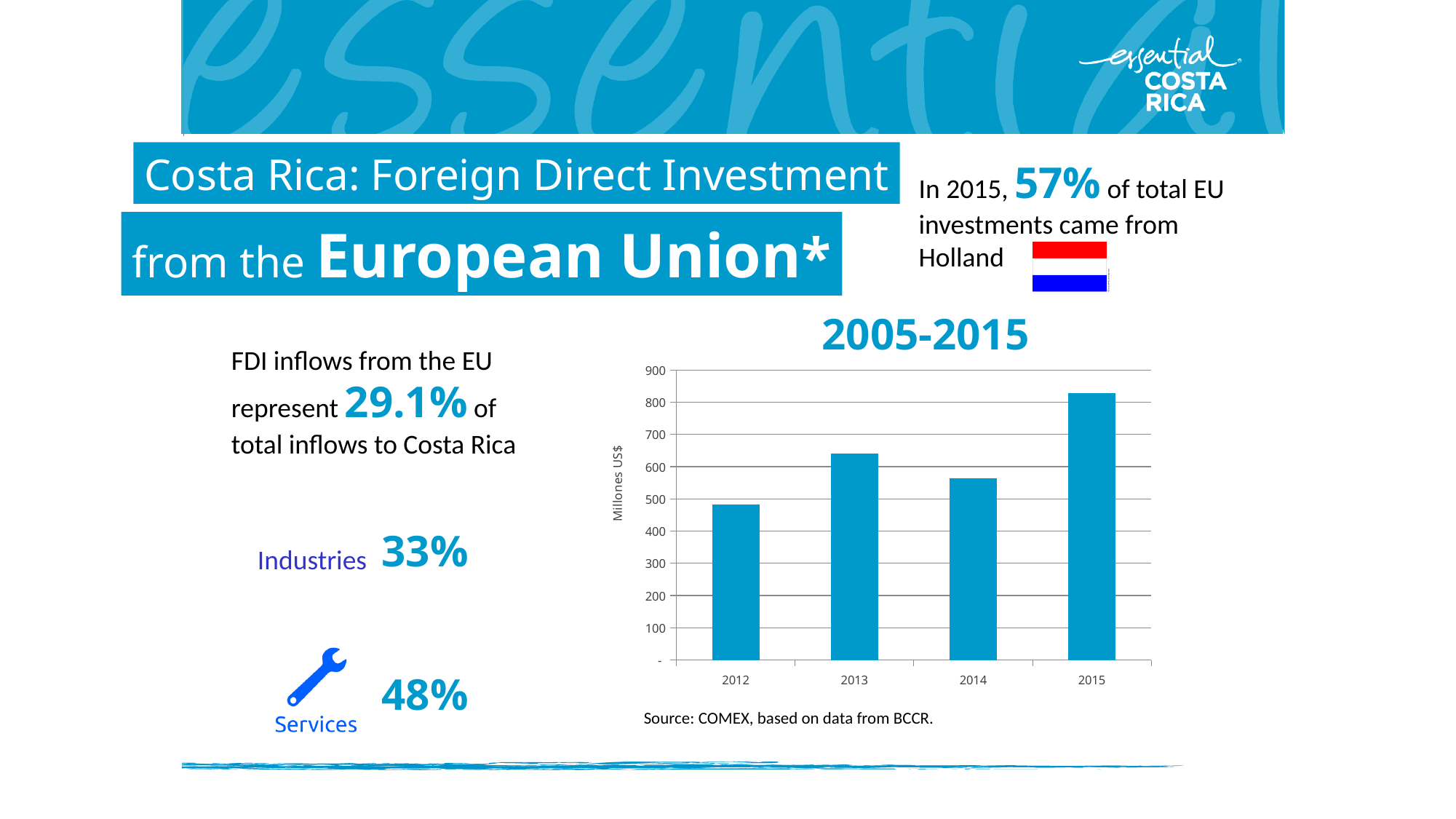
Is the value for 2013 greater or less than 600? greater Which year has the larger value, 2012 or 2015? 2015 Is the value for 2014 greater or less than 600? less How many years are plotted on the bar chart? 4 What is the title shown above the chart? 2005-2015 Which year has the highest bar on the chart? 2015 Which year has the larger value, 2013 or 2014? 2013 Which year has the lowest bar on the chart? 2012 Is the value for 2012 greater or less than 500? less What kind of chart is shown on the slide? bar chart What is the label on the vertical axis of the chart? Millones US$